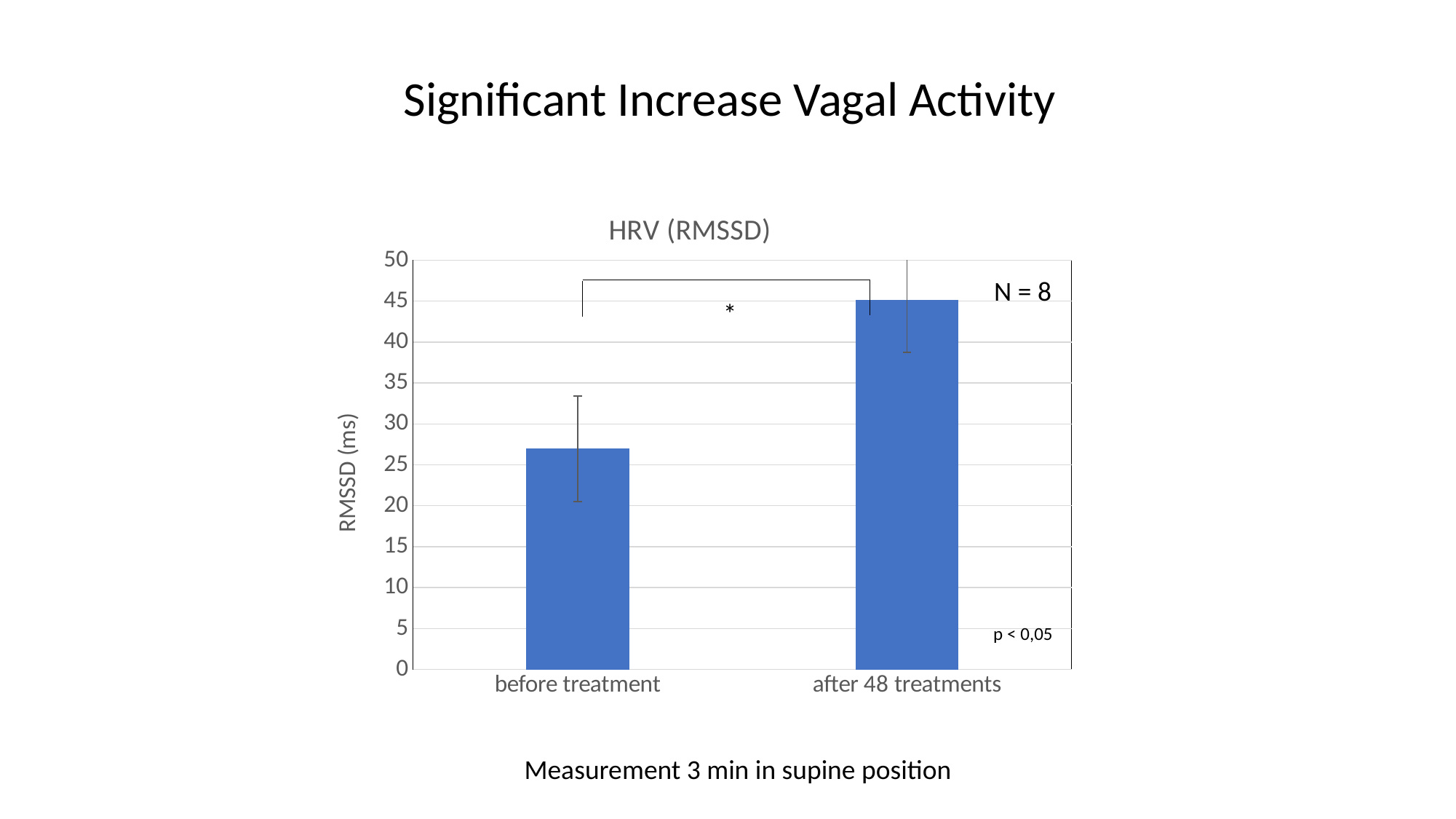
What kind of chart is shown on the slide? bar chart What is the label of the y axis of the chart? RMSSD (ms) What is the title of the chart? HRV (RMSSD) Do the values rise or fall from before treatment to after 48 treatments? rise Is the value for before treatment greater or less than 30? less Which category has the lowest RMSSD value? before treatment Which category has the highest RMSSD value? after 48 treatments Is the value for after 48 treatments greater or less than 40? greater Is the value for after 48 treatments greater or less than 50? less Which is larger, the value for before treatment or the value for after 48 treatments? after 48 treatments How many categories are plotted on the x axis of the chart? 2